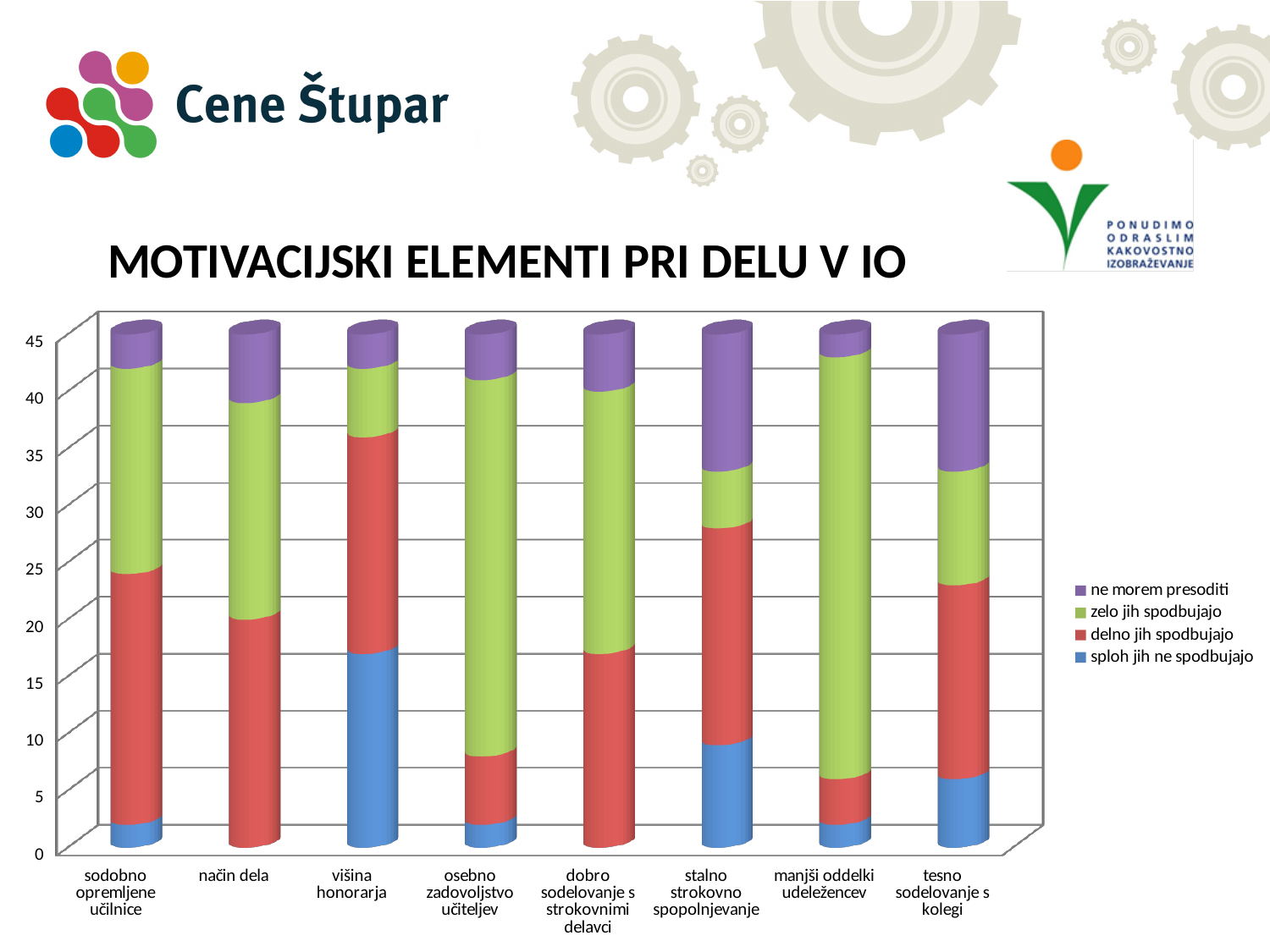
How many categories are shown along the x axis of the chart? 8 Is the 'spoloh jih ne spodbujajo' value for 'stalno strokovno spopolnjevanje' greater or less than 5? greater Is the 'zelo jih spodbujajo' value for 'osebno zadovoljstvo učiteljev' greater or less than 30? greater What is the title of the chart on the slide? MOTIVACIJSKI ELEMENTI PRI DELU V IO How many series does the chart legend list? 4 Which category has the largest 'spoloh jih ne spodbujajo' segment? višina honorarja Which category has the largest 'zelo jih spodbujajo' segment? manjši oddelki udeležencev Which colour represents the series 'ne morem presoditi' in the chart? purple What kind of chart is shown on the slide? stacked bar chart Is the 'spoloh jih ne spodbujajo' value for 'višina honorarja' greater or less than 15? greater Which has the larger 'delno jih spodbujajo' segment: 'osebno zadovoljstvo učiteljev' or 'dobro sodelovanje s strokovnimi delavci'? dobro sodelovanje s strokovnimi delavci